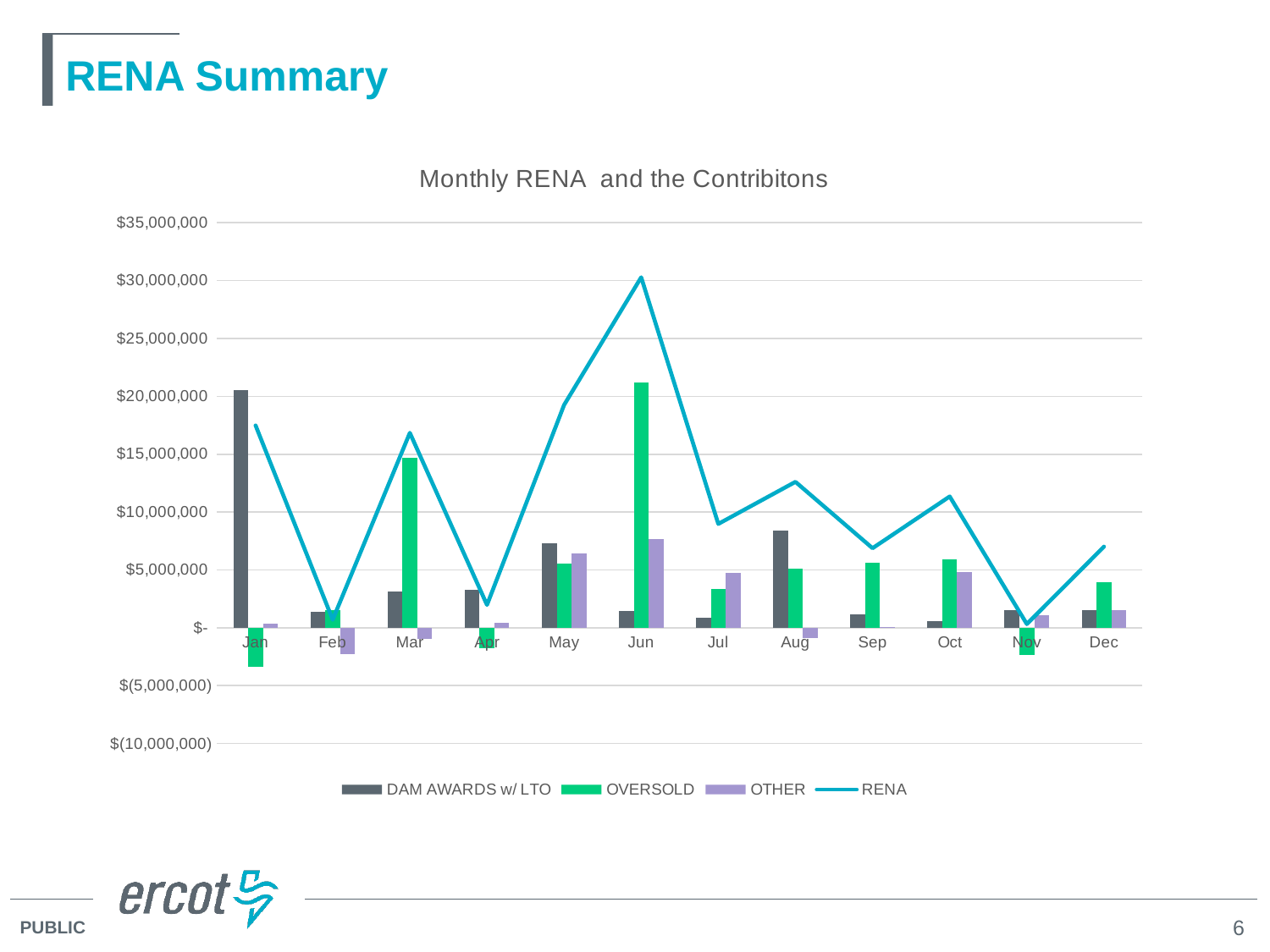
In which month is the DAM AWARDS w/ LTO bar the tallest? Jan In which month is the OVERSOLD bar the tallest? Jun Is the RENA value for Jun greater or less than $25,000,000? greater What is the title of the chart? Monthly RENA and the Contribitons In which month does the RENA line reach its lowest value? Nov In which month does the RENA line reach its highest value? Jun Which series is drawn as a line in the chart? RENA Does the RENA line rise or fall from Jun to Jul? fall How many months are shown on the x axis of the chart? 12 Is the OVERSOLD value for Mar greater or less than $10,000,000? greater How many series does the chart's legend list? 4 What kind of chart is shown on the slide? A combination bar and line chart